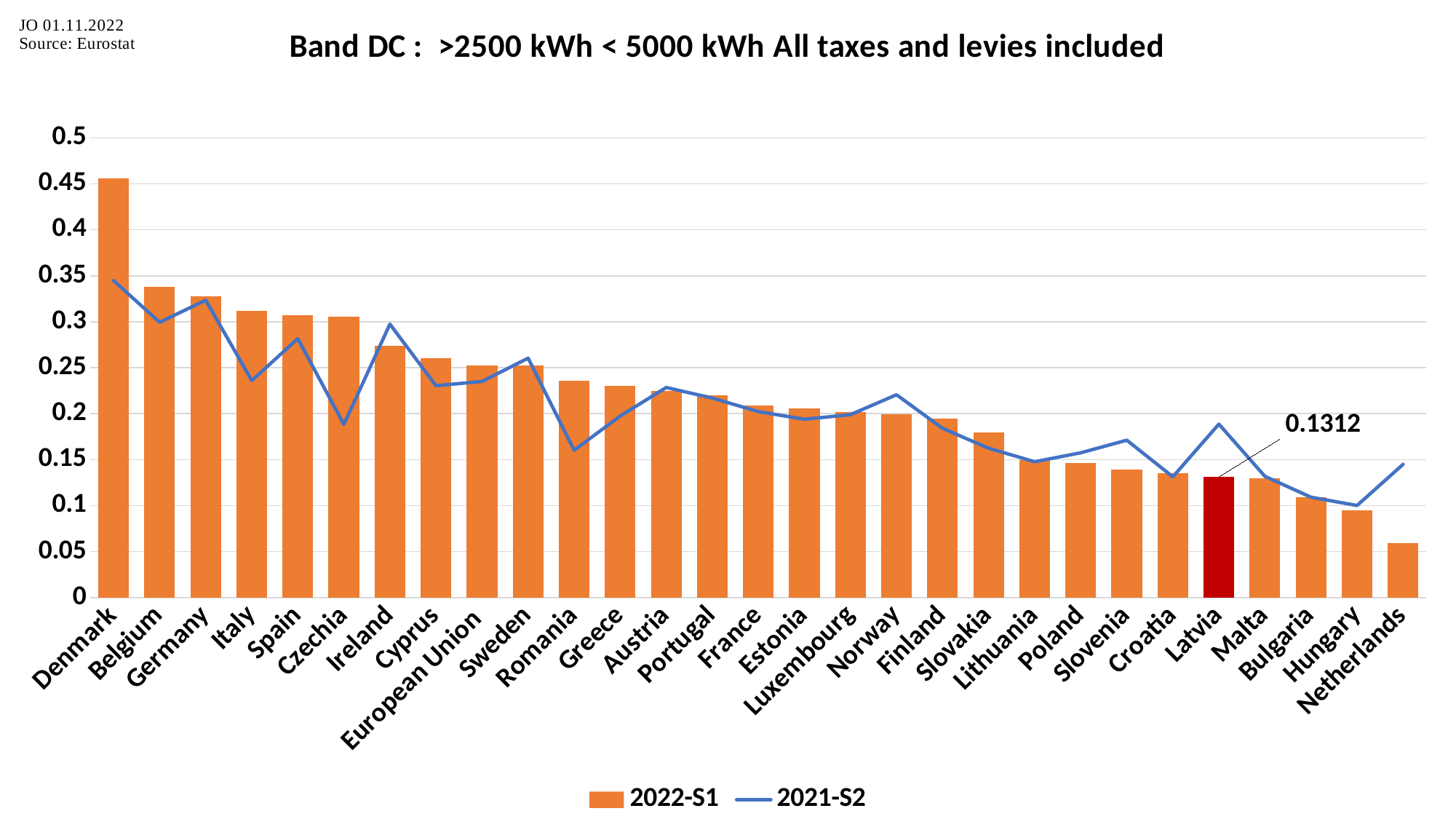
For Romania, which series has the larger value, 2022-S1 or 2021-S2? 2022-S1 Do the 2022-S1 bars generally rise or fall from left to right? fall Which country has the highest 2022-S1 bar? Denmark Is the 2021-S2 value for Ireland greater or less than 0.25? greater Is the 2022-S1 value for Denmark greater or less than 0.4? greater What is the 2022-S1 value shown for Latvia? 0.1312 Which country has the lowest 2022-S1 bar? Netherlands What kind of chart is this? A bar chart combined with a line chart How many series does the legend list? 2 How many countries/regions are shown on the x axis? 29 Which has the larger 2022-S1 value, Denmark or Belgium? Denmark Is the 2022-S1 value for Netherlands greater or less than 0.1? less